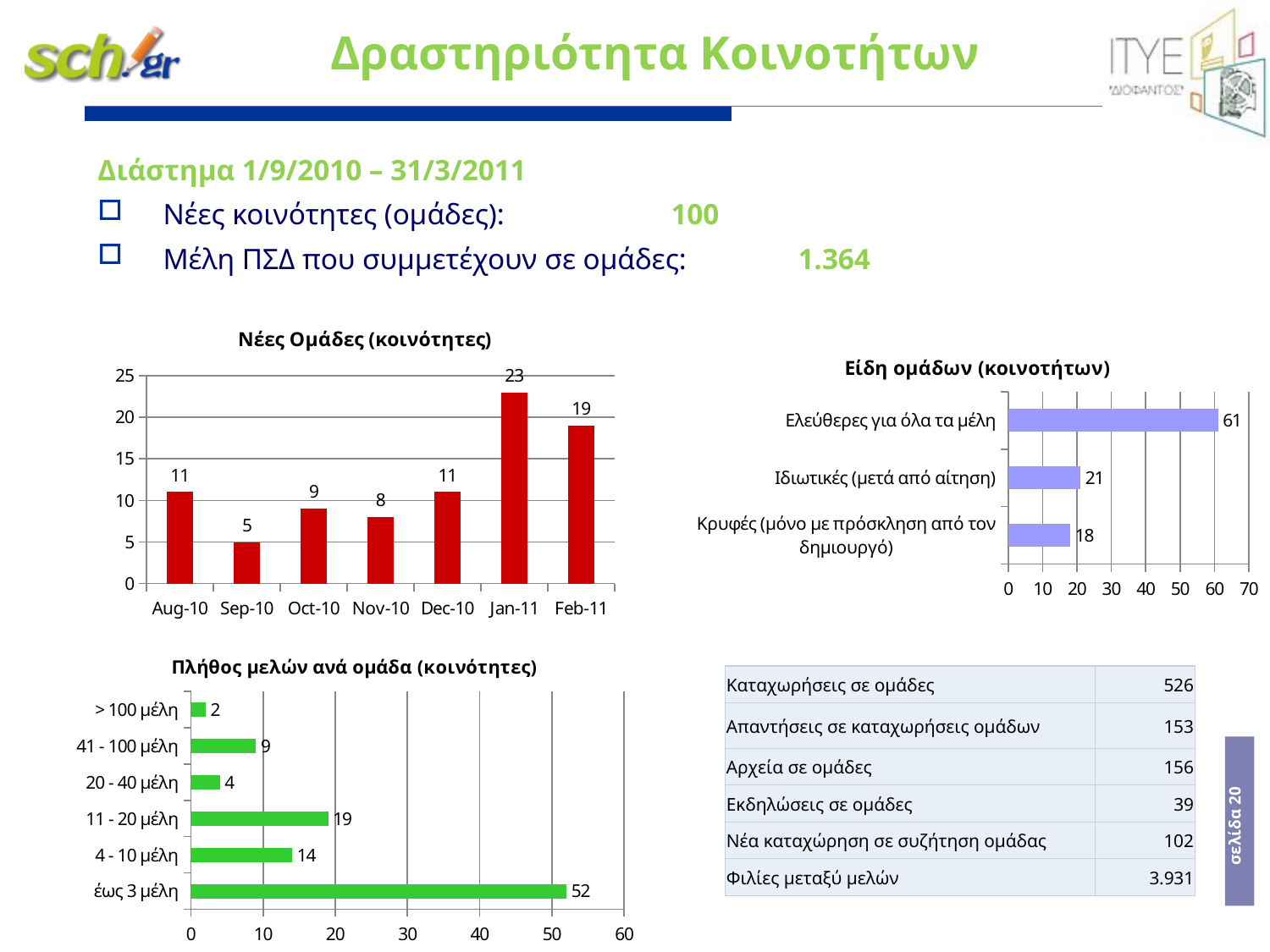
In the chart titled 'Πλήθος μελών ανά ομάδα (κοινότητες)', how many categories are shown? 6 In the chart titled 'Νέες Ομάδες (κοινότητες)', what is the value for Jan-11? 23 In the chart titled 'Είδη ομάδων (κοινοτήτων)', what is the value for 'Ιδιωτικές (μετά από αίτηση)'? 21 In the chart titled 'Πλήθος μελών ανά ομάδα (κοινότητες)', which category has the lowest value? > 100 μέλη In the chart titled 'Πλήθος μελών ανά ομάδα (κοινότητες)', what is the value for 'έως 3 μέλη'? 52 In the chart titled 'Είδη ομάδων (κοινοτήτων)', what is the difference between 'Ελεύθερες για όλα τα μέλη' and 'Κρυφές (μόνο με πρόσκληση από τον δημιουργό)'? 43 In the chart titled 'Πλήθος μελών ανά ομάδα (κοινότητες)', which is larger: '11 - 20 μέλη' or '4 - 10 μέλη'? 11 - 20 μέλη What kind of chart is 'Νέες Ομάδες (κοινότητες)'? bar chart In the chart titled 'Νέες Ομάδες (κοινότητες)', which month has the lowest value? Sep-10 In the chart titled 'Νέες Ομάδες (κοινότητες)', how many months are shown on the x axis? 7 In the chart titled 'Είδη ομάδων (κοινοτήτων)', which category has the highest value? Ελεύθερες για όλα τα μέλη In the chart titled 'Νέες Ομάδες (κοινότητες)', what is the difference between the values for Jan-11 and Feb-11? 4